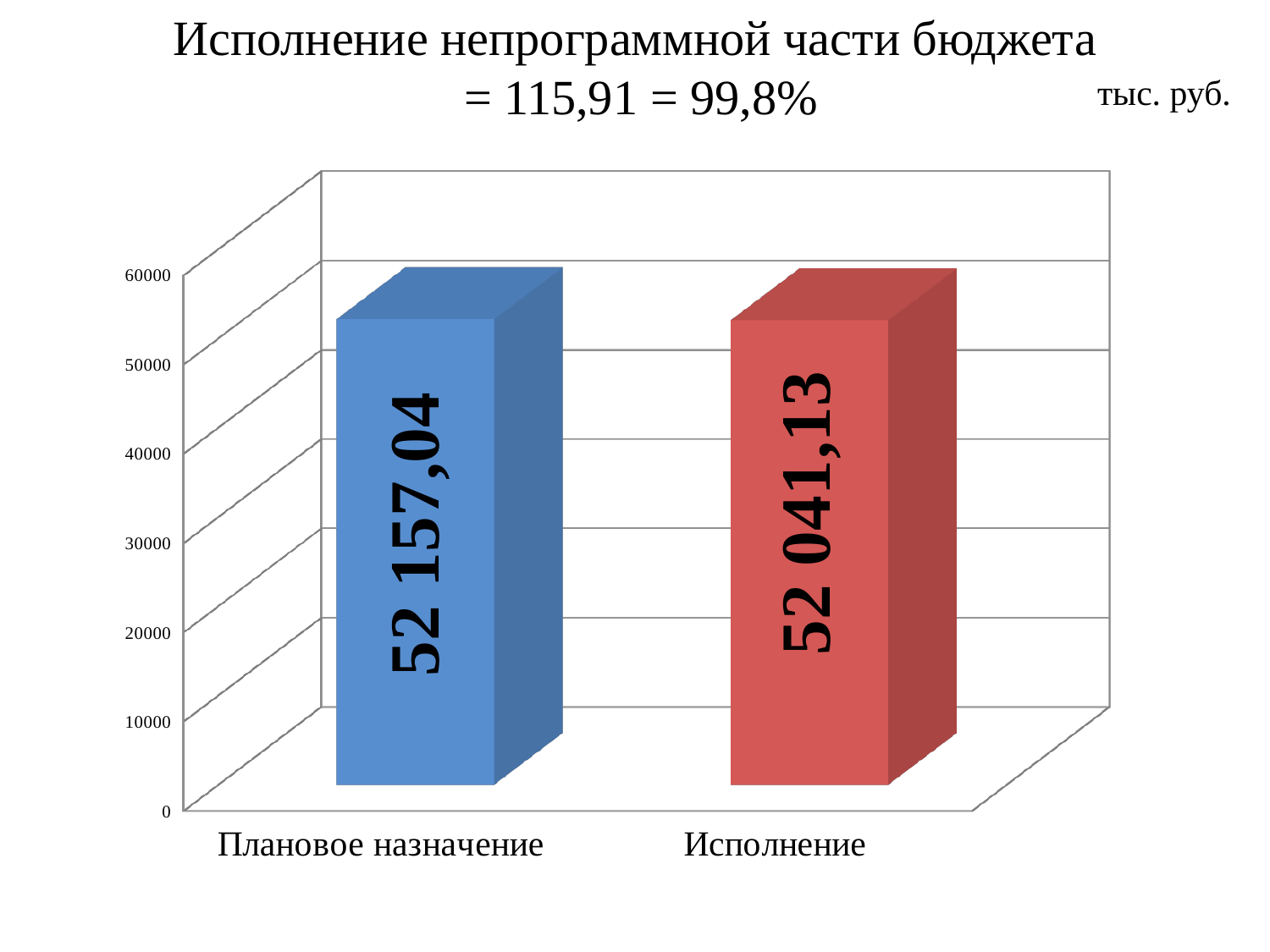
What is the value for Плановое назначение? 52 157,04 What is the difference between the values for Плановое назначение and Исполнение? 115,91 What colour is the bar for Исполнение? red What kind of chart is shown on the slide? bar chart What is the value for Исполнение? 52 041,13 Which category has the highest value? Плановое назначение Which category has the higher value, Плановое назначение or Исполнение? Плановое назначение How many categories are shown on the chart? 2 Which category has the lowest value? Исполнение Is the value for Исполнение greater or less than 50000? greater What unit of measurement is indicated on the slide? тыс. руб. Is the value for Плановое назначение greater or less than 60000? less